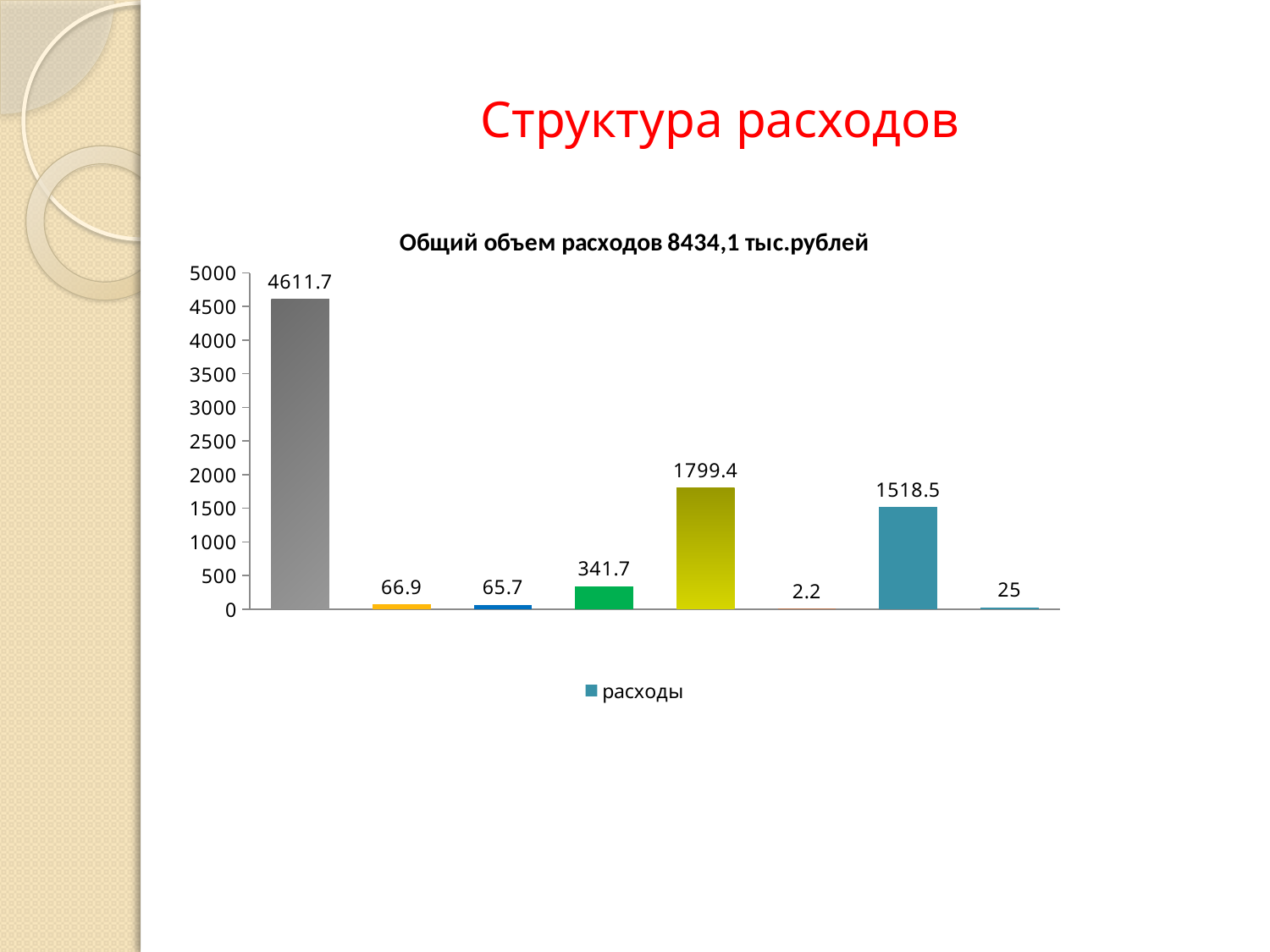
What type of chart is shown on the slide? bar chart What is the value of the fourth (green) bar? 341.7 What is the difference between the highest bar (4611.7) and the fifth bar (1799.4)? 2812.3 What is the name of the series shown in the legend? расходы What is the value of the seventh (teal) bar? 1518.5 How many bars are plotted in the chart? 8 How many series does the legend list? 1 What is the value of the first (grey) bar on the left? 4611.7 What is the title of the chart? Общий объем расходов 8434,1 тыс.рублей What is the value of the fifth (yellow-green) bar? 1799.4 Which bar has the lowest value, and what is it? The sixth bar, 2.2 Which is larger, the fifth bar (1799.4) or the seventh bar (1518.5)? The fifth bar (1799.4)